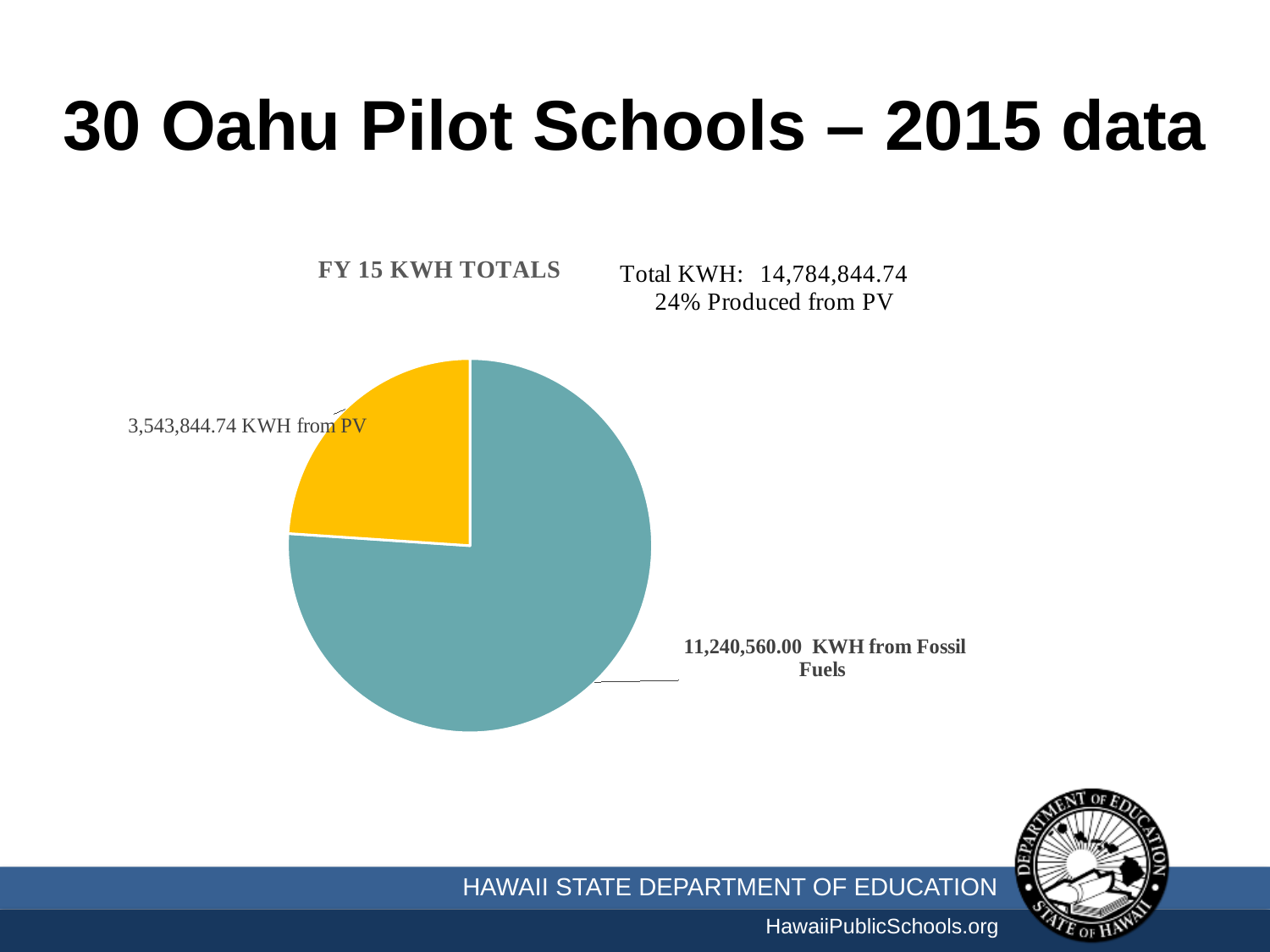
What is the title of the chart? FY 15 KWH TOTALS How many KWH came from PV according to the chart? 3,543,844.74 KWH Which is larger, the KWH from PV or the KWH from Fossil Fuels? KWH from Fossil Fuels What is the total KWH shown on the slide? 14,784,844.74 What is the difference in KWH between Fossil Fuels and PV? 7,696,715.26 KWH Which slice of the pie is the largest? KWH from Fossil Fuels Which slice of the pie is the smallest? KWH from PV How many KWH came from Fossil Fuels according to the chart? 11,240,560.00 KWH What kind of chart is shown on the slide? pie chart What colour is the slice representing KWH from PV? yellow How many slices does the pie chart have? 2 What share of the total KWH was produced from PV? 24%